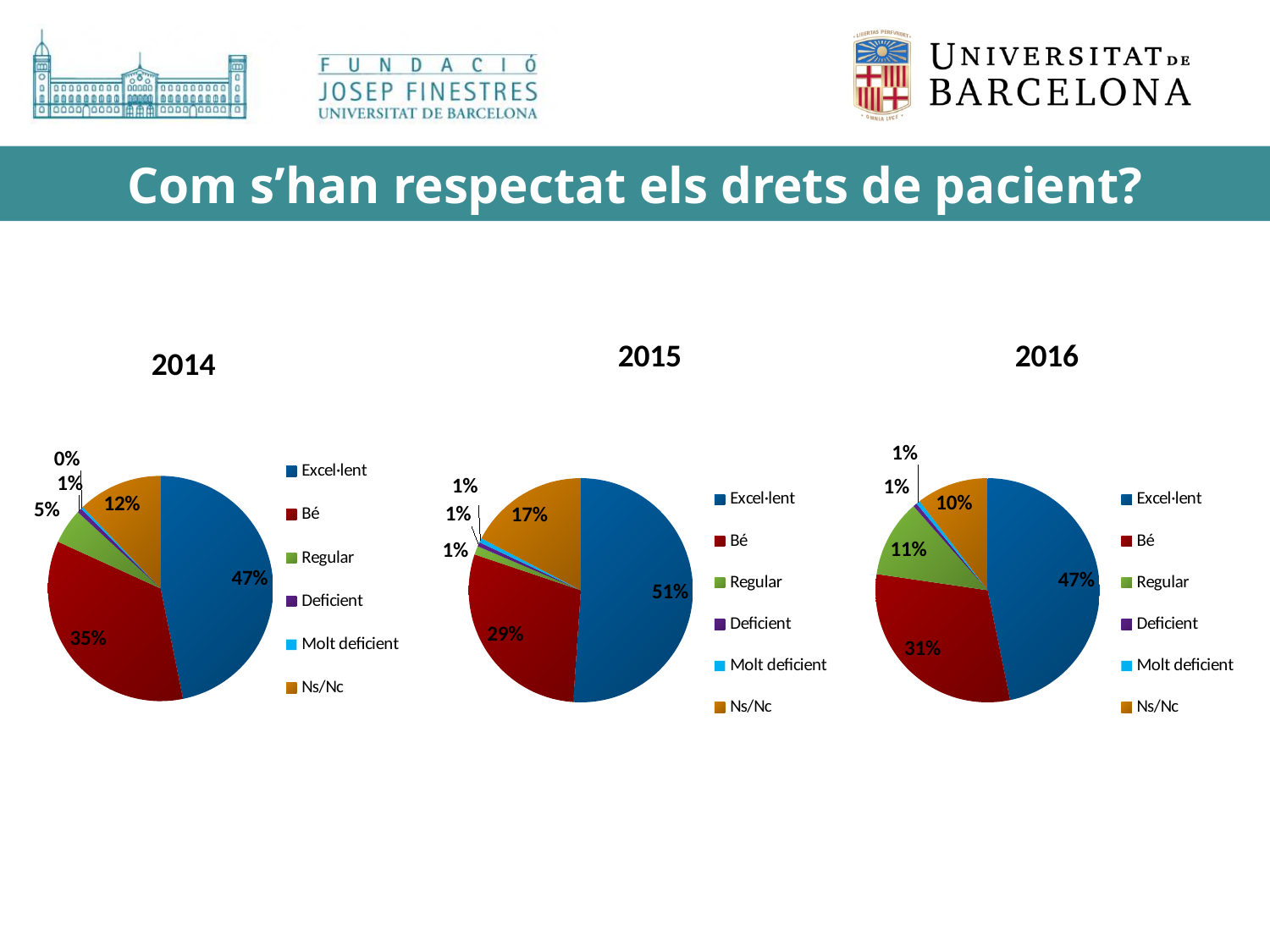
In the 2015 pie chart, what percentage is shown for Ns/Nc? 17% What kind of chart is used for the 2015 data? Pie chart In the 2016 pie chart, which category has the largest share? Excel·lent What is the title of the pie chart on the right of the slide? 2016 How many pie charts are shown on the slide? 3 In the 2014 pie chart, what percentage is shown for Ns/Nc? 12% How many categories does the legend of the 2016 pie chart list? 6 In the 2015 pie chart, which is larger, the Ns/Nc share or the Bé share? Bé In the 2016 pie chart, what percentage is shown for Regular? 11% In the 2014 pie chart, what percentage is shown for Excel·lent? 47% In the 2015 pie chart, what percentage is shown for Bé? 29% In the 2014 pie chart, what is the difference between the Excel·lent and Bé shares? 12%